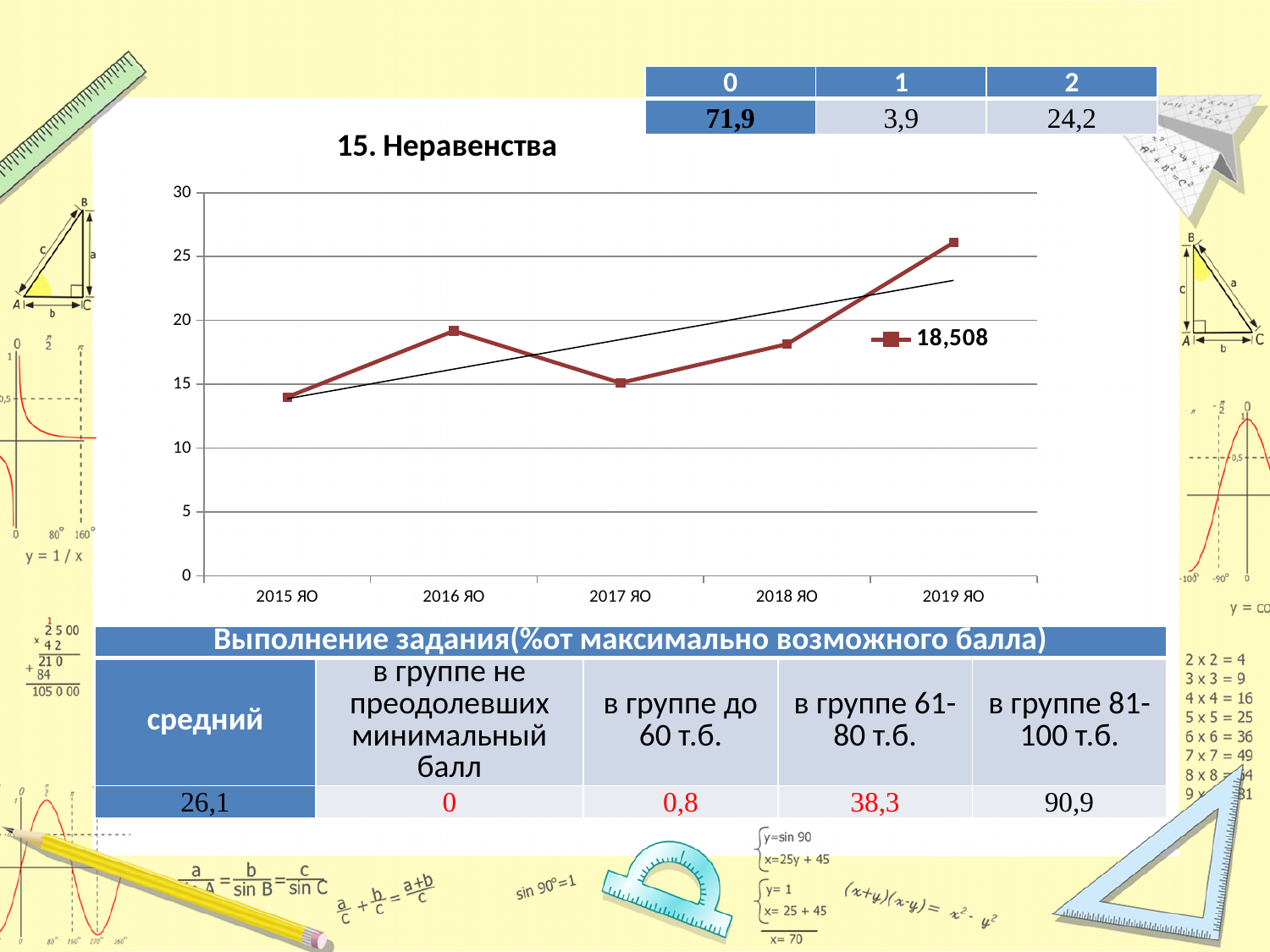
What is the title of the chart? 15. Неравенства Does the value rise or fall from 2018 ЯО to 2019 ЯО? rise Is the value for 2019 ЯО greater or less than 25? greater Which is larger, the value for 2016 ЯО or the value for 2017 ЯО? 2016 ЯО How many points are plotted along the x axis of the chart? 5 What is the legend entry for the plotted series? 18,508 Is the value for 2017 ЯО greater or less than 20? less Which year has the lowest value on the chart? 2015 ЯО What kind of chart is shown on the slide? line chart Which year has the highest value on the chart? 2019 ЯО Is the value for 2015 ЯО greater or less than 15? less How many series does the chart legend list? 1